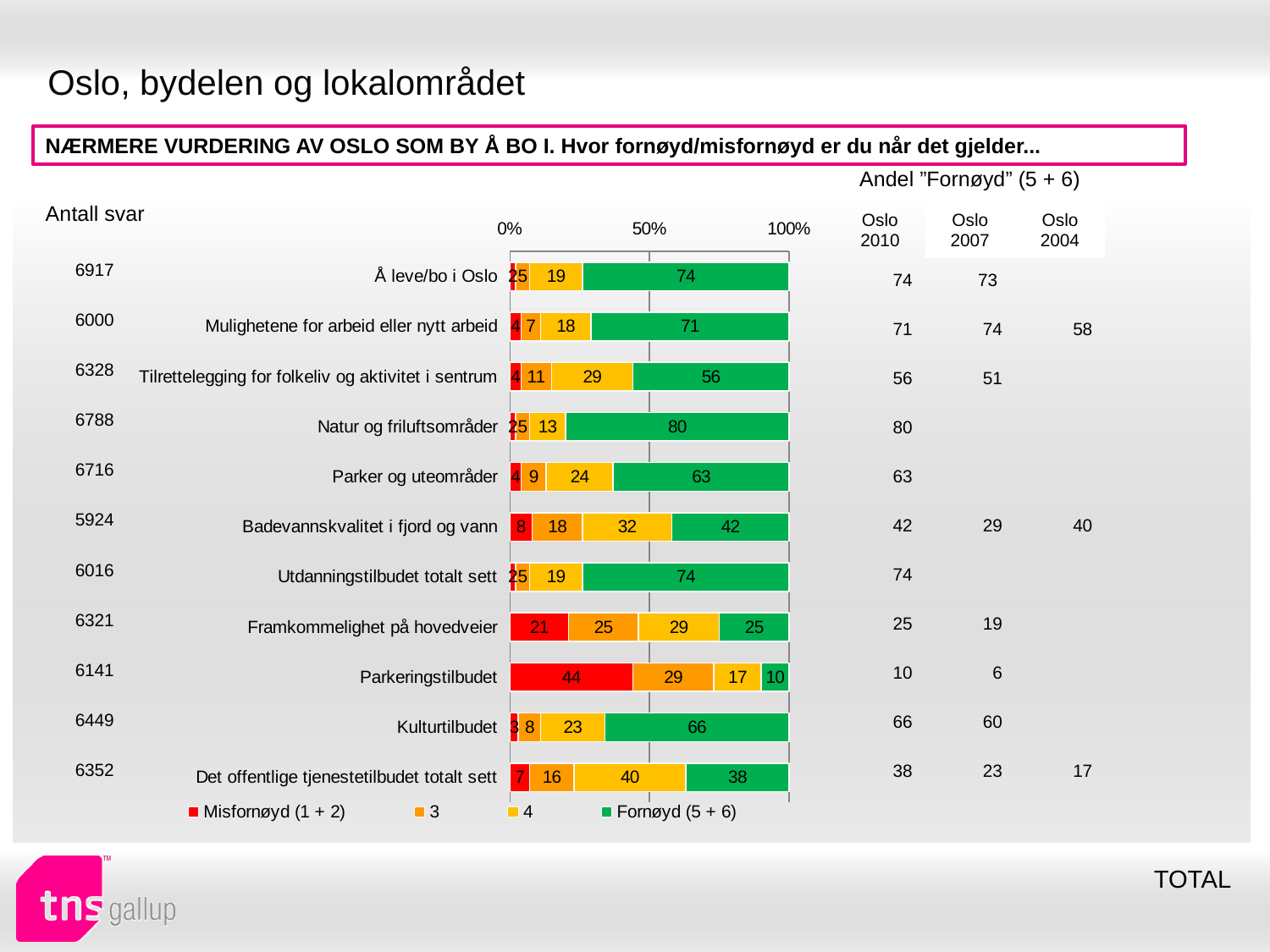
How many series does the legend list? 4 What type of chart is shown on the slide? Stacked bar chart Which category has the lowest Fornøyd (5 + 6) value? Parkeringstilbudet Which category has the highest Misfornøyd (1 + 2) value? Parkeringstilbudet What is the value of the Fornøyd (5 + 6) series for Natur og friluftsområder? 80 Which category has the highest Fornøyd (5 + 6) value? Natur og friluftsområder What is the value of the series '4' for Det offentlige tjenestetilbudet totalt sett? 40 What is the difference between the Fornøyd (5 + 6) values for Kulturtilbudet and Badevannskvalitet i fjord og vann? 24 Which has a larger Fornøyd (5 + 6) value: Parker og uteområder or Tilrettelegging for folkeliv og aktivitet i sentrum? Parker og uteområder How many categories are shown in the chart? 11 What is the value of the series '3' for Framkommelighet på hovedveier? 25 What is the Misfornøyd (1 + 2) value for Parkeringstilbudet? 44